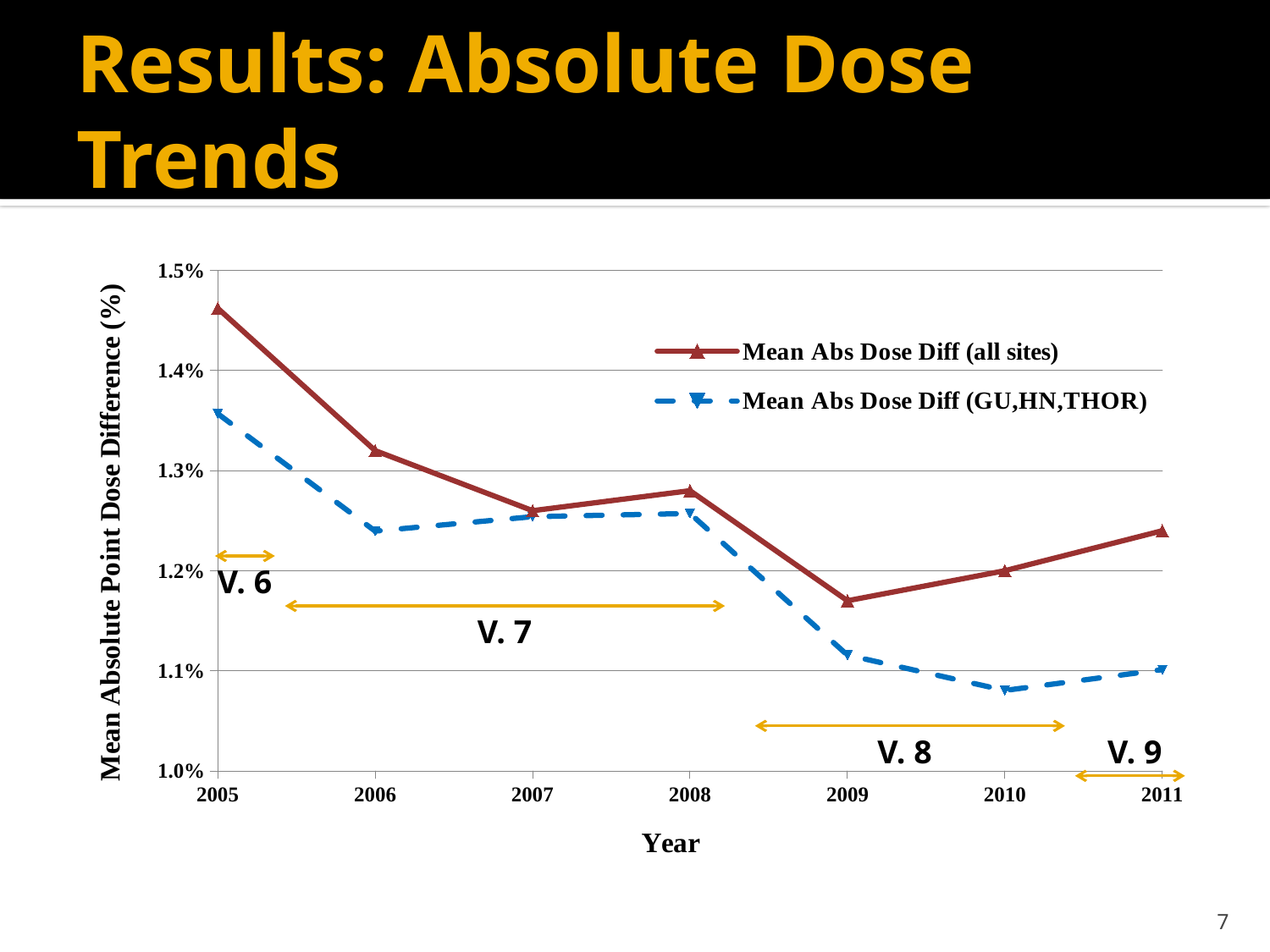
Is the Mean Abs Dose Diff (all sites) value for 2005 greater or less than 1.4%? greater How many series does the legend list? 2 Which series has the larger value in 2009, Mean Abs Dose Diff (all sites) or Mean Abs Dose Diff (GU,HN,THOR)? Mean Abs Dose Diff (all sites) What is the label of the x axis? Year Does the Mean Abs Dose Diff (all sites) series generally rise or fall from 2005 to 2009? fall Is the Mean Abs Dose Diff (all sites) value for 2009 greater or less than 1.2%? less In which year is the Mean Abs Dose Diff (all sites) lowest? 2009 What kind of chart is shown on the slide? line chart In which year is the Mean Abs Dose Diff (all sites) highest? 2005 Is the Mean Abs Dose Diff (GU,HN,THOR) value for 2010 greater or less than 1.1%? less How many years are plotted along the x axis? 7 In which year is the Mean Abs Dose Diff (GU,HN,THOR) lowest? 2010